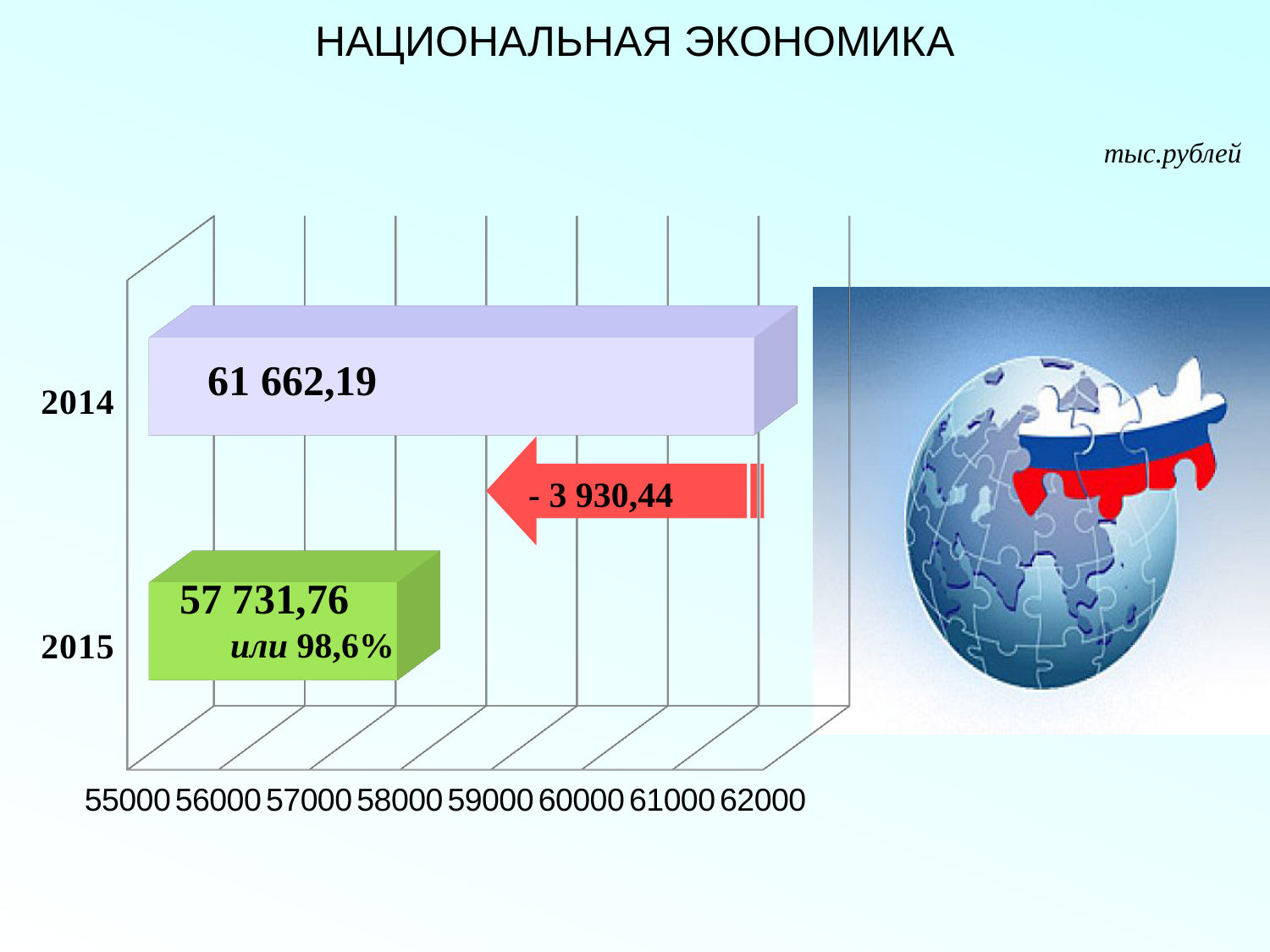
What kind of chart is shown on the slide? bar chart Is the value for 2014 greater or less than 61000? greater What is the value for 2015? 57 731,76 Is the value for 2015 greater or less than 58000? less Is the value for 2015 larger or smaller than the value for 2014? smaller What is the value for 2014? 61 662,19 Which year has the lower value? 2015 What percentage of the 2014 value does the 2015 value represent, as printed on the slide? 98,6% How many bars are shown in the chart? 2 Which year has the higher value? 2014 What is the difference between the 2014 and 2015 values? 3 930,44 What unit of measurement is indicated for the chart? тыс.рублей